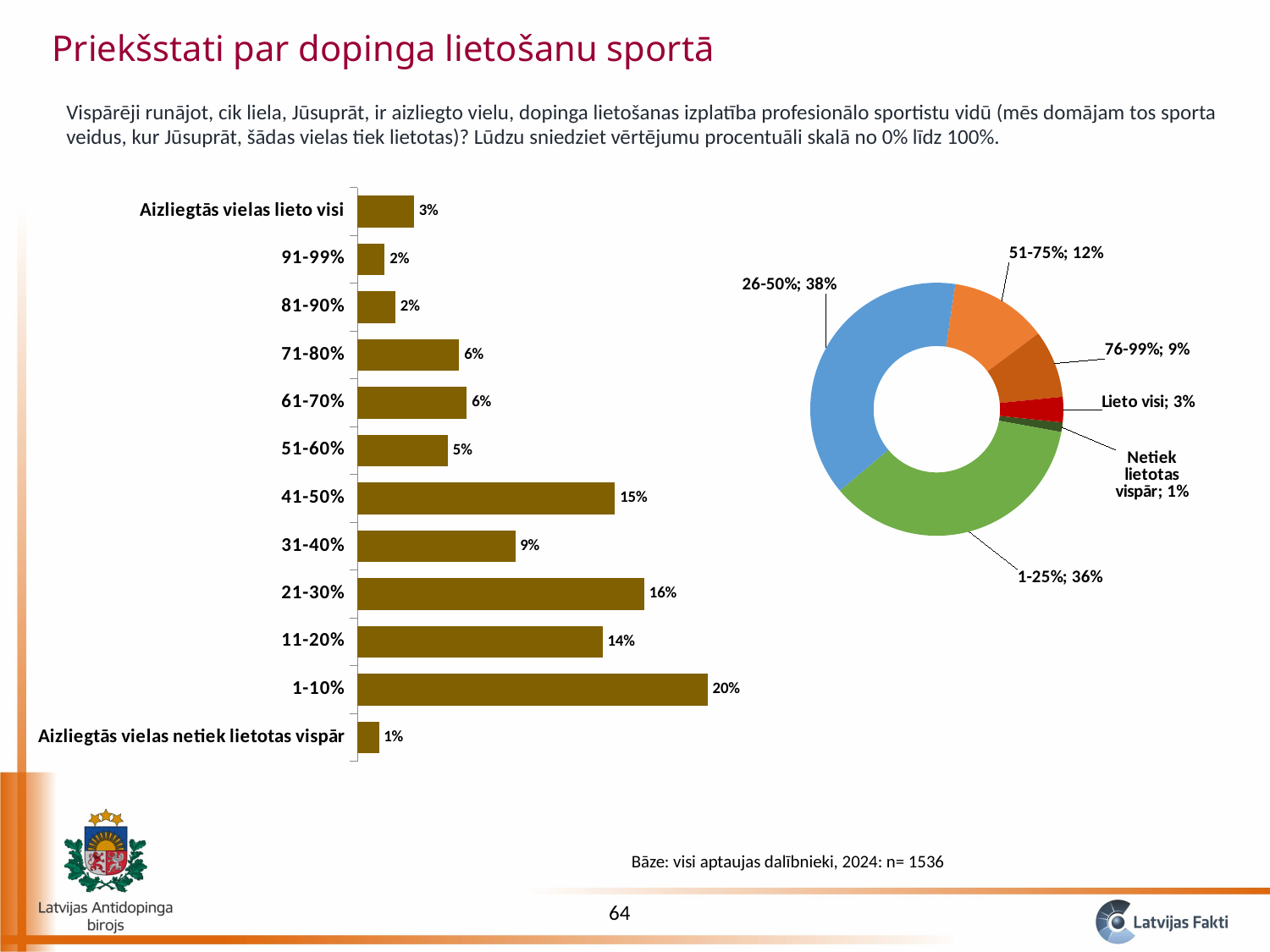
How many slices does the doughnut chart on the right have? 6 In the doughnut chart on the right, what is the difference between the slices "51-75%" and "76-99%"? 3% In the bar chart on the left, what is the difference between the values for "21-30%" and "11-20%"? 2% In the bar chart on the left, what is the value for the category "41-50%"? 15% What type of chart is shown on the left of the slide? Bar chart In the doughnut chart on the right, what is the value for the slice "26-50%"? 38% In the bar chart on the left, which category has the lowest value? Aizliegtās vielas netiek lietotas vispār In the bar chart on the left, which category has the highest value? 1-10% In the doughnut chart on the right, which slice is the largest? 26-50% How many categories are shown in the bar chart on the left? 12 In the bar chart on the left, which is larger: the value for "31-40%" or the value for "51-60%"? 31-40% In the bar chart on the left, what is the value for the category "1-10%"? 20%